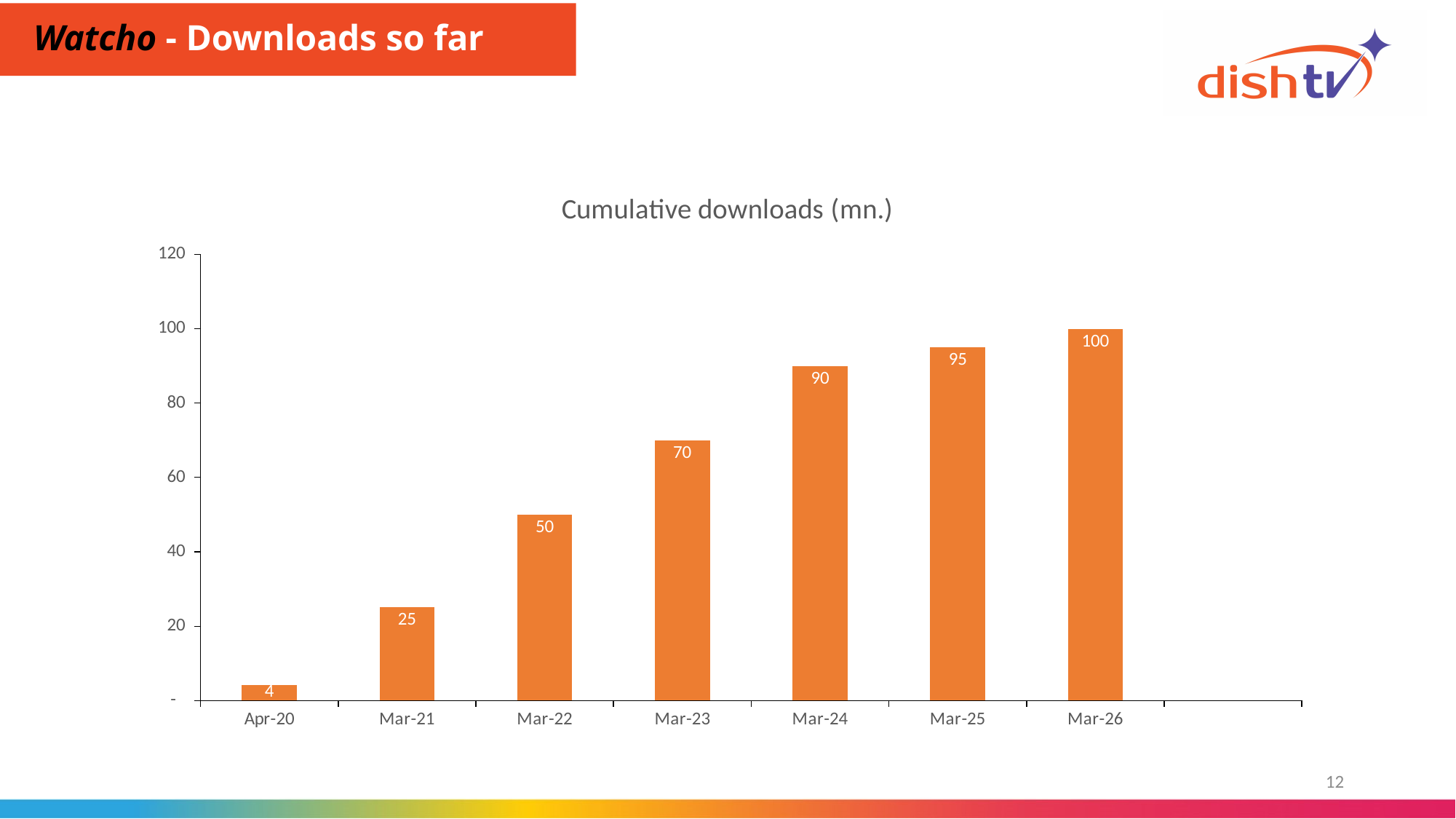
Which period has the highest cumulative downloads? Mar-26 How many periods are shown on the x axis of the chart? 7 What is the difference in cumulative downloads between Mar-26 and Mar-21? 75 Is the value for Mar-23 greater or less than 60? greater What is the cumulative downloads value for Mar-25? 95 Which is larger, the cumulative downloads for Mar-21 or Mar-22? Mar-22 Do the cumulative downloads rise or fall from Apr-20 to Mar-26? Rise What is the difference in cumulative downloads between Mar-24 and Mar-22? 40 What kind of chart is shown on the slide? Bar chart What is the cumulative downloads value for Apr-20? 4 Which period has the lowest cumulative downloads? Apr-20 What is the cumulative downloads value for Mar-23? 70